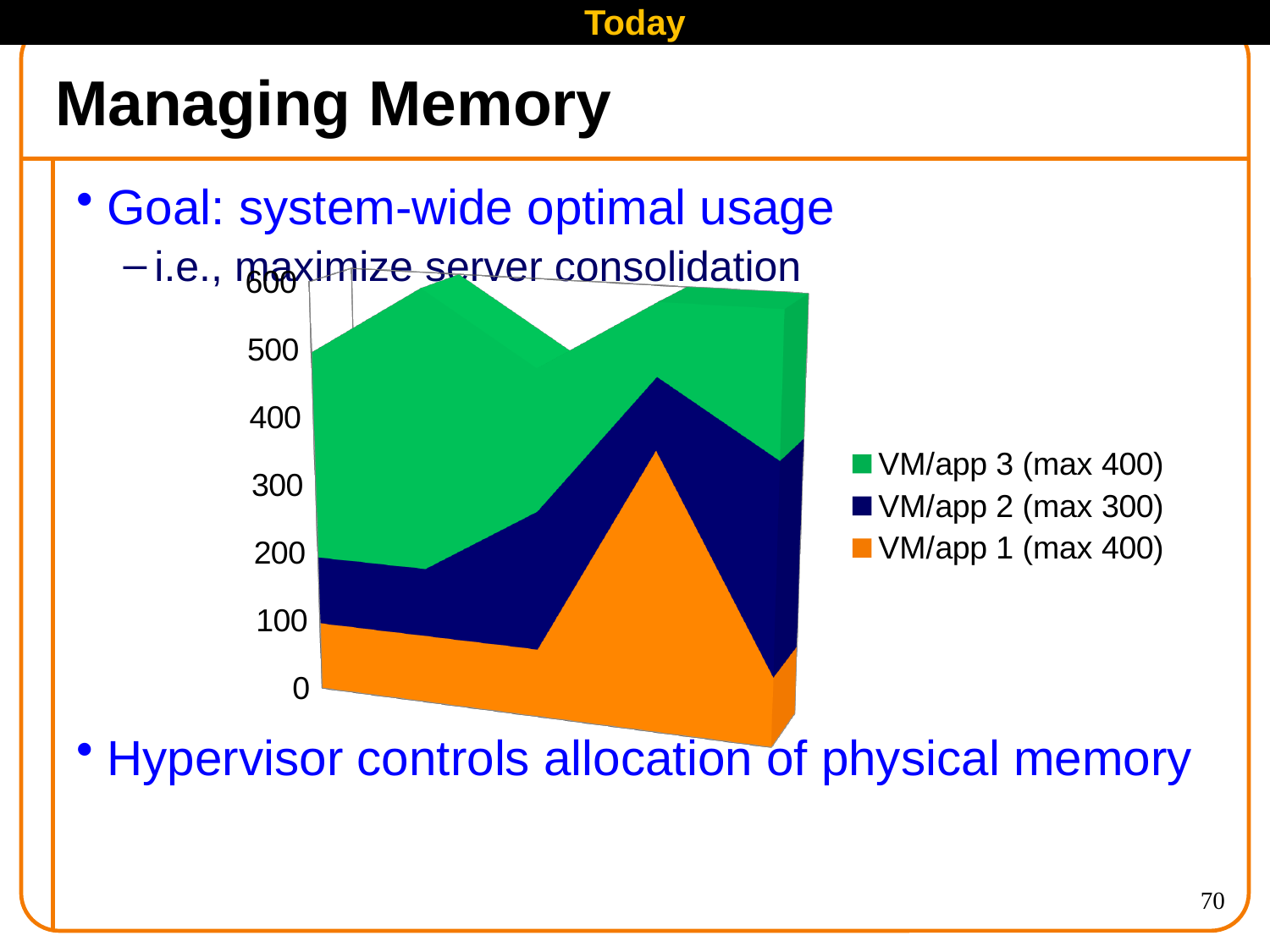
Is the highest point of the stacked total in the chart greater or less than 500? greater What is the maximum value shown on the chart's vertical axis? 600 What colour represents VM/app 1 (max 400) in the chart? orange How many series does the chart legend list? 3 What kind of chart is shown on the slide? area chart Which series is listed first in the chart legend? VM/app 3 (max 400) Is the peak value of VM/app 1 (max 400) in the chart greater or less than 200? greater